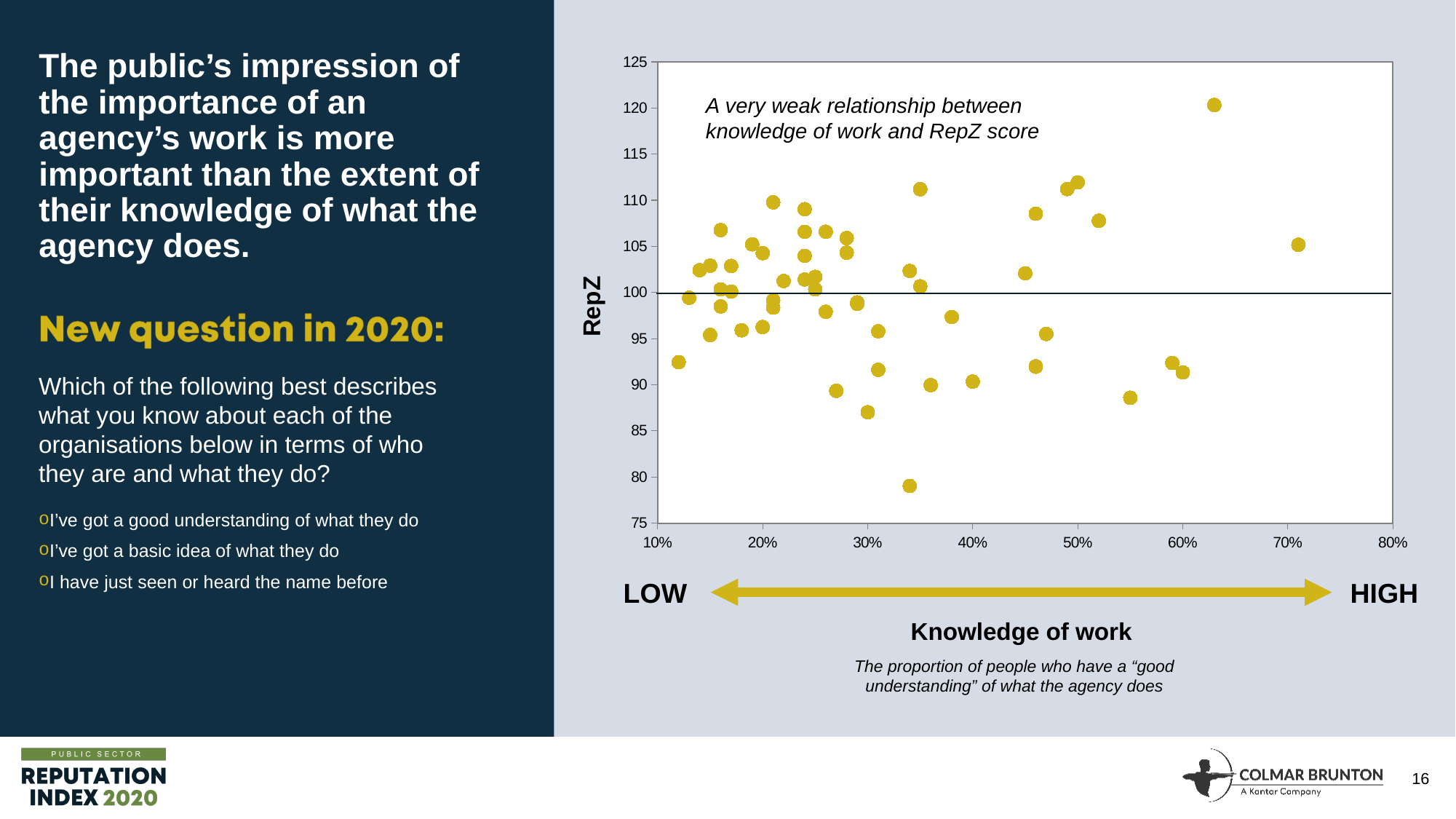
According to the annotation on the chart, how strong is the relationship between knowledge of work and RepZ score? Very weak Is the RepZ score of the point with the lowest knowledge of work greater or less than 95? less Is the knowledge-of-work value of the point with the highest RepZ score greater or less than 60%? greater Is the highest RepZ value plotted on the chart greater or less than 115? greater What is the label of the vertical axis of the chart? RepZ What kind of chart is shown on the slide? Scatter plot At what RepZ value is the horizontal reference line drawn across the chart? 100